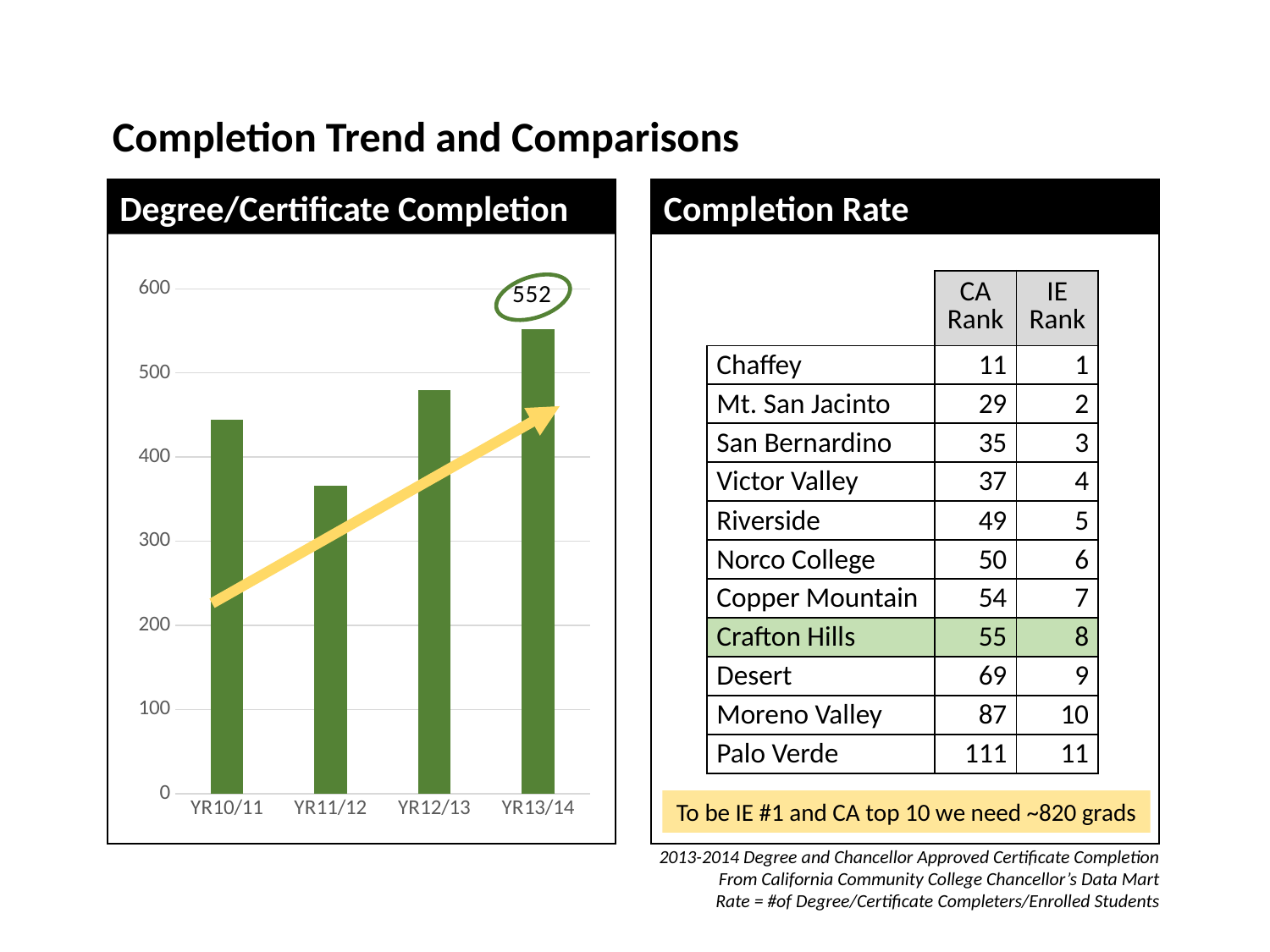
How many years are shown on the x axis of the Degree/Certificate Completion chart? 4 In the Degree/Certificate Completion chart, is the value for YR10/11 greater or less than 400? greater What is the highest value shown on the y axis of the Degree/Certificate Completion chart? 600 Which year has the lowest value in the Degree/Certificate Completion chart? YR11/12 What kind of chart is the Degree/Certificate Completion chart? bar chart What is the value for YR13/14 in the Degree/Certificate Completion chart? 552 In the Degree/Certificate Completion chart, is the value for YR12/13 greater or less than 500? less In the Degree/Certificate Completion chart, is the value for YR11/12 greater or less than 400? less In the Degree/Certificate Completion chart, does the value rise or fall from YR10/11 to YR11/12? fall In the Degree/Certificate Completion chart, which is larger, the value for YR12/13 or YR10/11? YR12/13 Which year has the highest value in the Degree/Certificate Completion chart? YR13/14